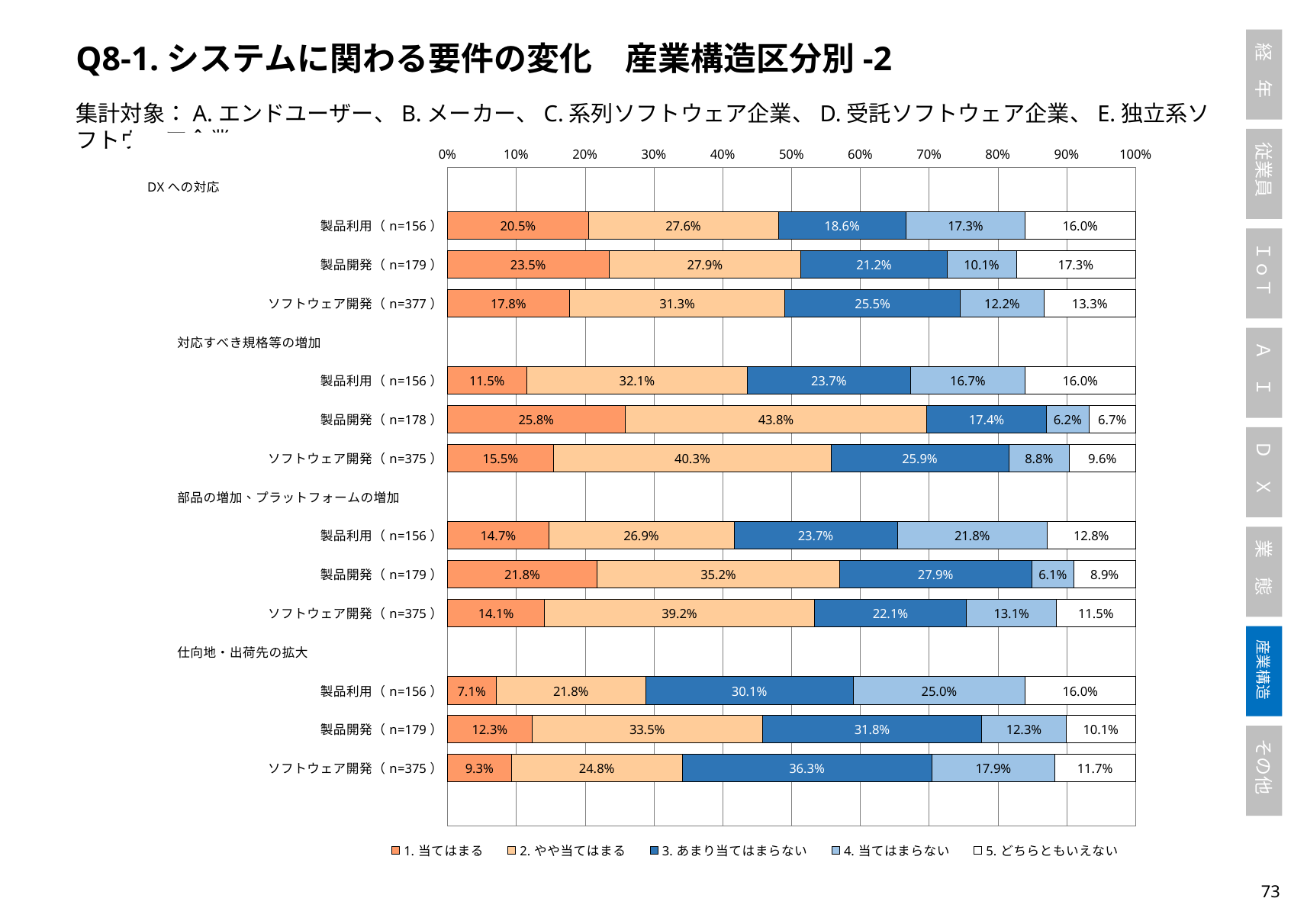
How many series does the legend list? 5 In the '部品の増加、プラットフォームの増加' group, what is the value of '5. どちらともいえない' for ソフトウェア開発 (n=375)? 11.5% In the '仕向地・出荷先の拡大' group, which row has the highest value for '1. 当てはまる'? 製品開発 (n=179) What kind of chart is shown on the slide? Stacked horizontal bar chart In the '部品の増加、プラットフォームの増加' group, which has the larger '4. 当てはまらない' value: 製品利用 (n=156) or 製品開発 (n=179)? 製品利用 (n=156) In the '仕向地・出荷先の拡大' group, what is the value of '3. あまり当てはまらない' for ソフトウェア開発 (n=375)? 36.3% How many bars are plotted in the chart? 12 What is the first entry in the chart's legend? 1. 当てはまる In the '対応すべき規格等の増加' group, what is the difference between the '2. やや当てはまる' values for 製品開発 (n=178) and 製品利用 (n=156)? 11.7 percentage points In the '対応すべき規格等の増加' group, what is the value of '2. やや当てはまる' for 製品開発 (n=178)? 43.8% In the 'DX への対応' group, which row has the lowest value for '4. 当てはまらない'? 製品開発 (n=179) In the 'DX への対応' group, what is the value of '1. 当てはまる' for 製品利用 (n=156)? 20.5%